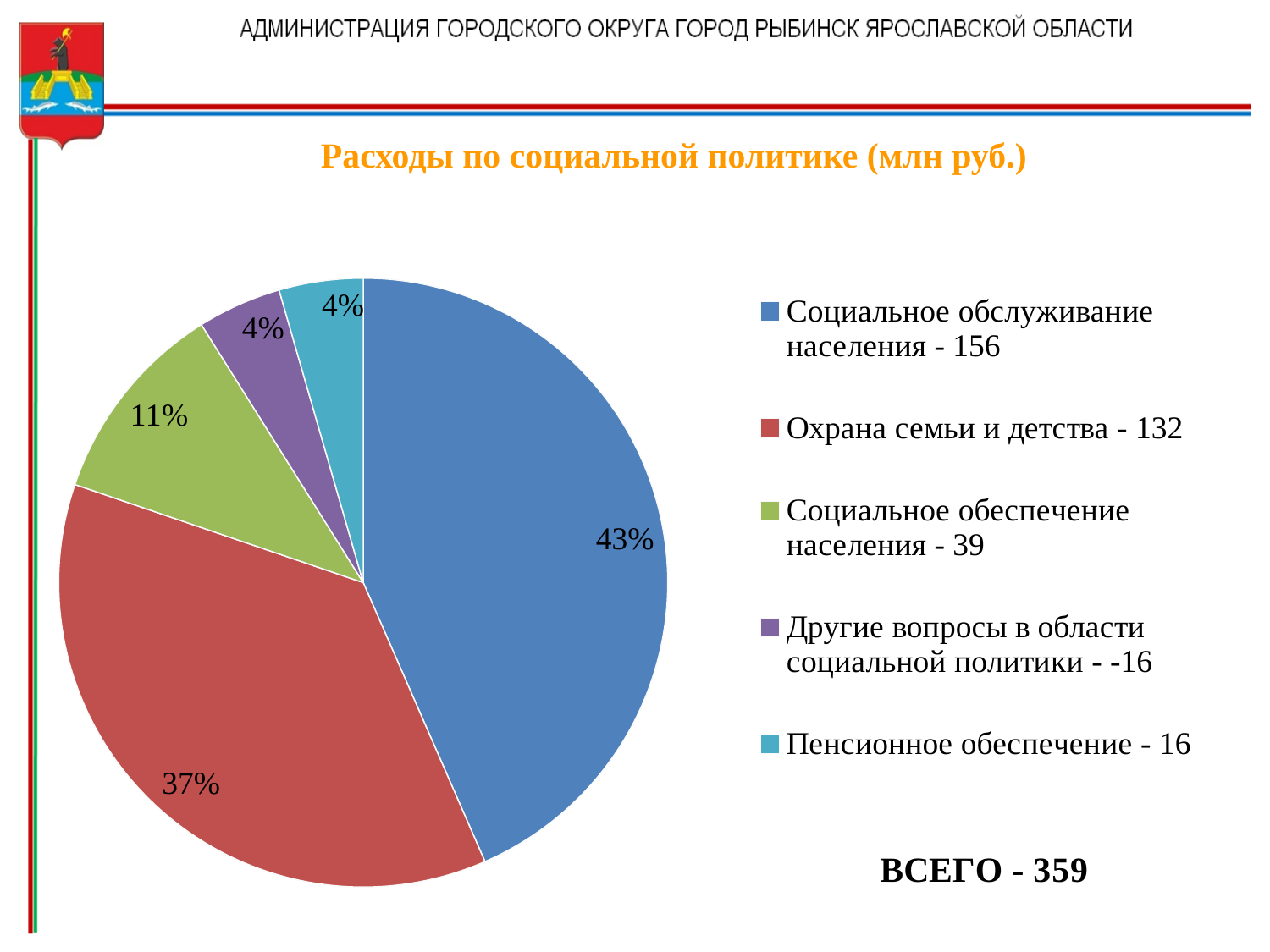
What share of the pie does "Социальное обслуживание населения" take? 43% What value is given in the legend for "Охрана семьи и детства"? 132 Which category has the largest slice of the pie? Социальное обслуживание населения What value is given in the legend for "Социальное обслуживание населения"? 156 What value is given in the legend for "Пенсионное обеспечение"? 16 What share of the pie does "Охрана семьи и детства" take? 37% Which is larger, the slice for "Социальное обеспечение населения" or the slice for "Пенсионное обеспечение"? Социальное обеспечение населения What kind of chart is shown on the slide? Pie chart What share of the pie does "Социальное обеспечение населения" take? 11% What is the difference between the values for "Социальное обслуживание населения" and "Охрана семьи и детства"? 24 What is the title of the chart? Расходы по социальной политике (млн руб.) How many slices does the pie chart have? 5